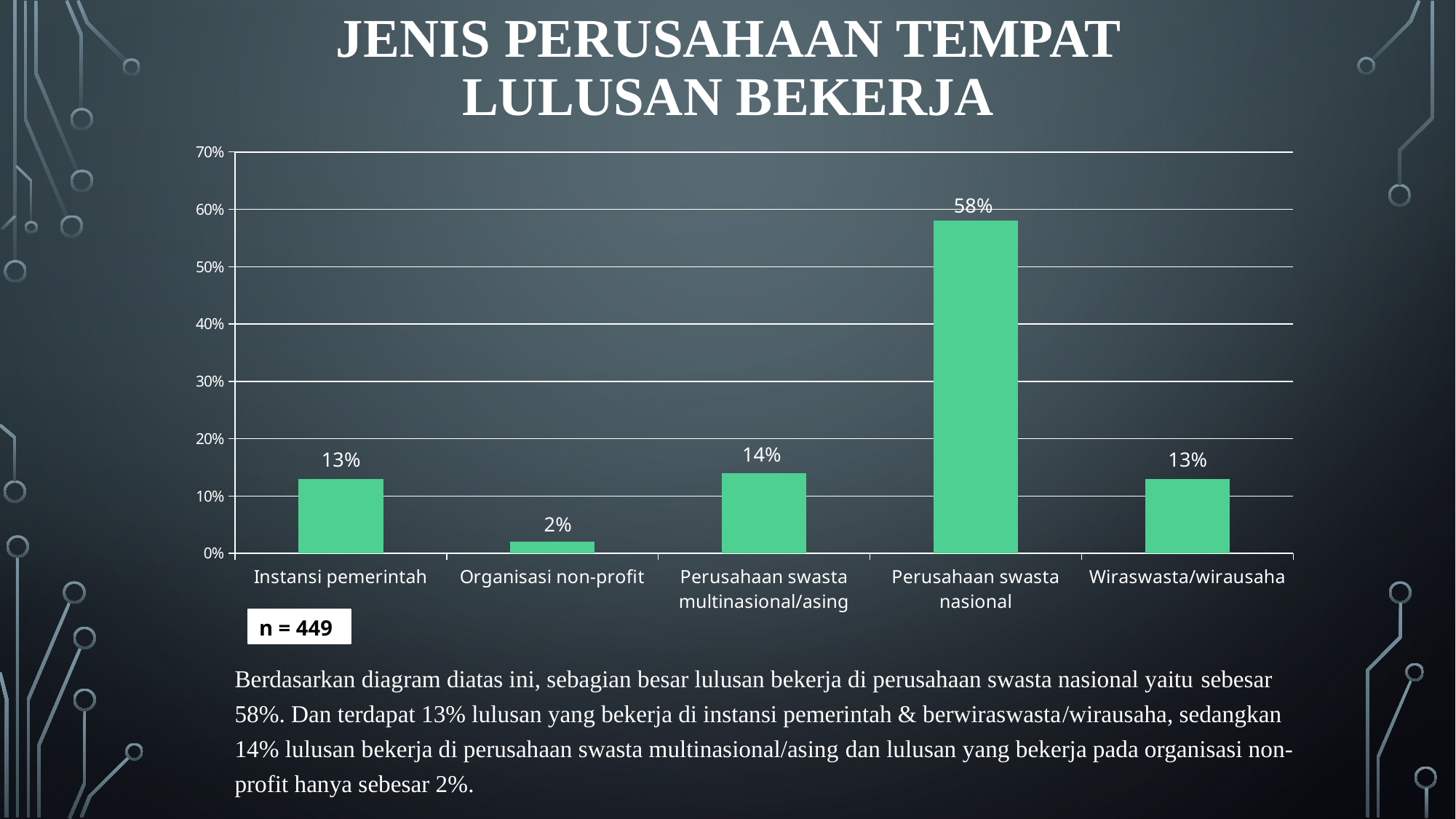
What is the value for Organisasi non-profit? 2% What is the value for Wiraswasta/wirausaha? 13% What kind of chart is shown on the slide? bar chart Is the value for Perusahaan swasta nasional greater or less than 50%? greater Which is larger, the value for Instansi pemerintah or the value for Organisasi non-profit? Instansi pemerintah What is the difference between the values for Perusahaan swasta nasional and Perusahaan swasta multinasional/asing? 44% What is the value for Perusahaan swasta multinasional/asing? 14% What sample size (n) is shown below the chart? n = 449 Which category has the highest value? Perusahaan swasta nasional What is the value for Perusahaan swasta nasional? 58% How many categories are shown on the x axis? 5 Which category has the lowest value? Organisasi non-profit